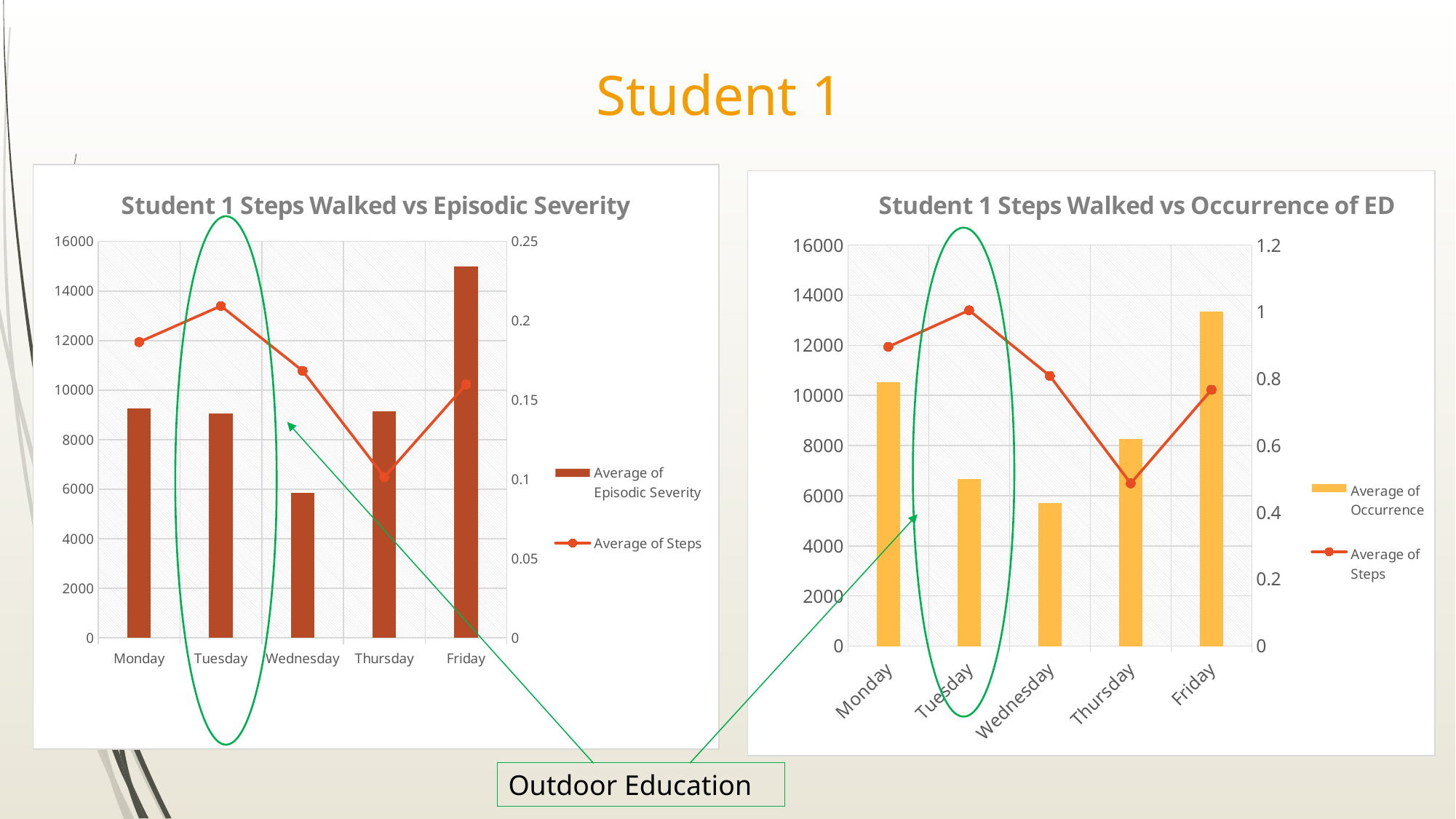
In the chart titled 'Student 1 Steps Walked vs Episodic Severity', on which day does the Average of Steps line reach its highest point? Tuesday In the chart titled 'Student 1 Steps Walked vs Occurrence of ED', on which day does the Average of Steps line reach its lowest point? Thursday How many series does the legend of the chart titled 'Student 1 Steps Walked vs Occurrence of ED' list? 2 In the chart titled 'Student 1 Steps Walked vs Occurrence of ED', which day has the tallest Average of Occurrence bar? Friday In the chart titled 'Student 1 Steps Walked vs Occurrence of ED', is the Average of Occurrence bar taller for Monday or for Tuesday? Monday What is the text in the box below the two charts that the green arrows point from? Outdoor Education In the chart titled 'Student 1 Steps Walked vs Occurrence of ED', which day has the shortest Average of Occurrence bar? Wednesday How many days are shown on the x axis of the chart titled 'Student 1 Steps Walked vs Episodic Severity'? 5 In the chart titled 'Student 1 Steps Walked vs Occurrence of ED', measured against the left axis, is the Friday bar greater or less than 12000? greater In the chart titled 'Student 1 Steps Walked vs Episodic Severity', which day has the shortest Average of Episodic Severity bar? Wednesday In the chart titled 'Student 1 Steps Walked vs Episodic Severity', which day has the tallest Average of Episodic Severity bar? Friday